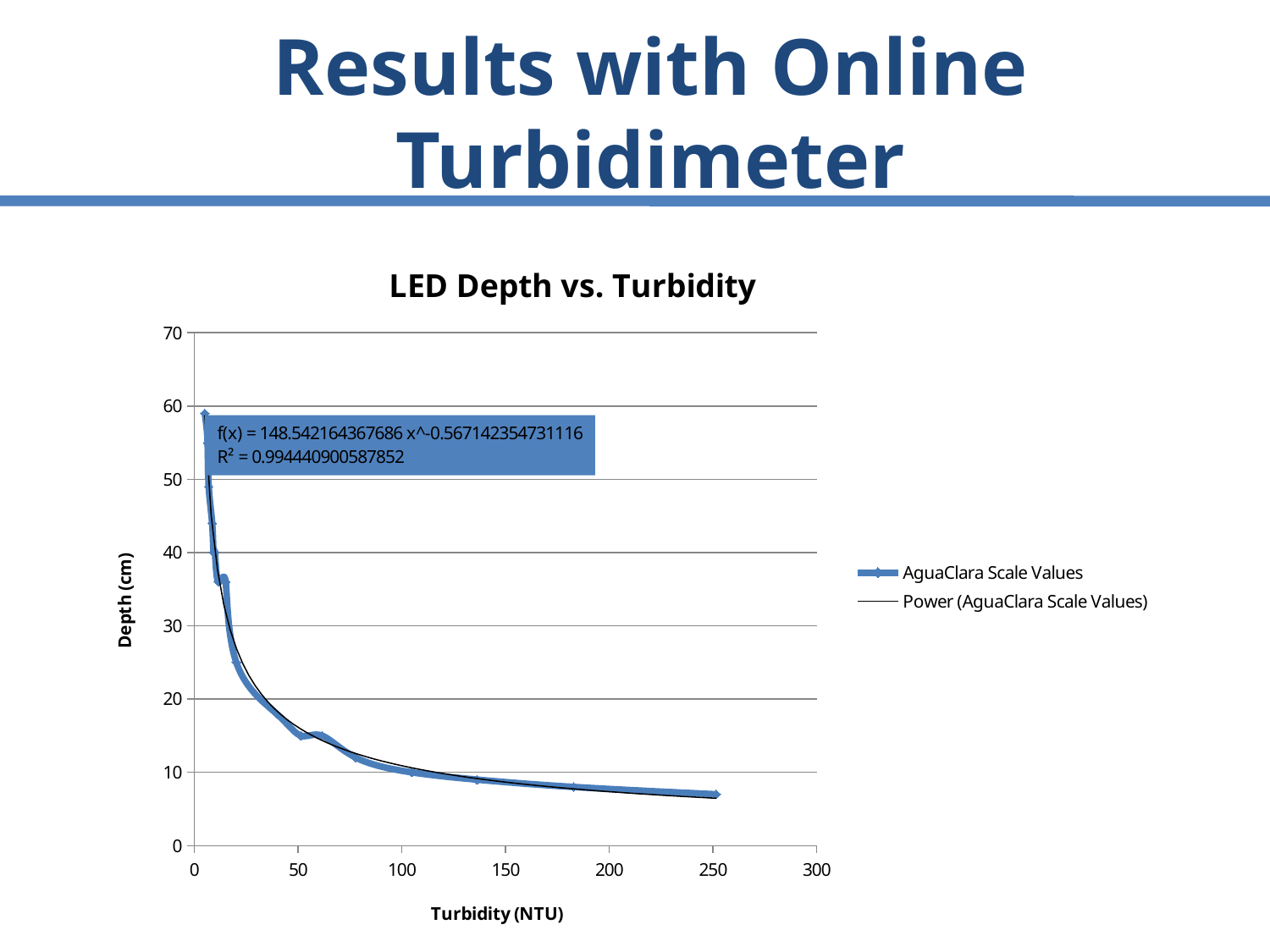
Is the highest plotted depth value greater or less than 50? greater What is the title of the chart? LED Depth vs. Turbidity How many entries does the chart's legend list? 2 What kind of chart is shown on the slide? Line chart (scatter with trendline) Does the depth rise or fall as turbidity increases along the x axis? Fall Which is larger: the depth at a turbidity of about 50 NTU or the depth at about 250 NTU? Depth at about 50 NTU What R² value is printed for the power trendline? R² = 0.994440900587852 What is the coefficient in the printed trendline equation f(x)? 148.542164367686 Is the depth value at a turbidity of about 250 NTU greater or less than 10? less Is the depth value at a turbidity of about 100 NTU greater or less than 20? less What is the exponent of x in the printed trendline equation f(x)? -0.567142354731116 What is the label of the x axis? Turbidity (NTU)